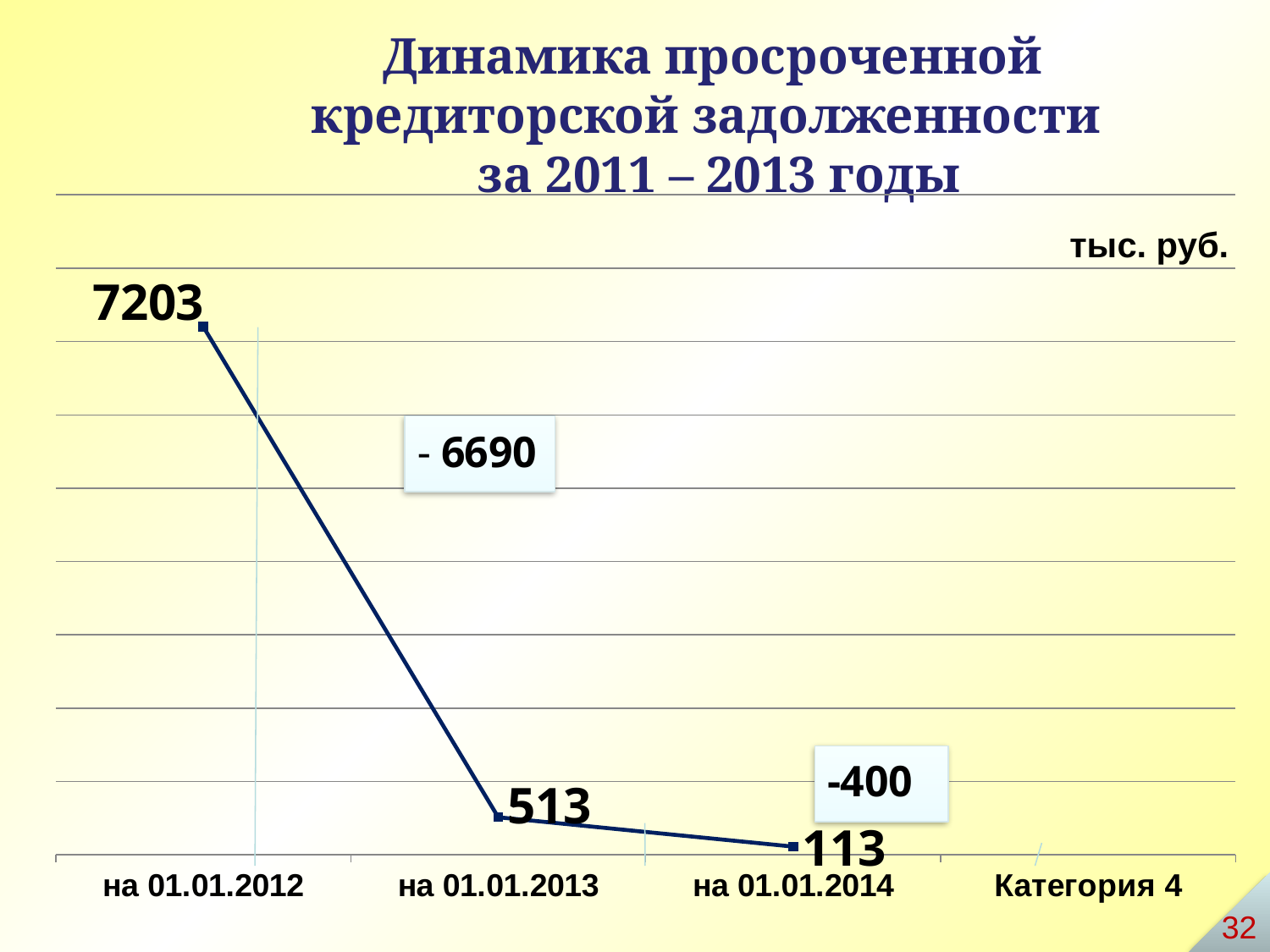
What is the value for на 01.01.2014? 113 Do the values rise or fall from на 01.01.2012 to на 01.01.2014? fall What is the difference between the values for на 01.01.2013 and на 01.01.2014? 400 Which date has the lowest value? на 01.01.2014 In what units are the values on the chart expressed? тыс. руб. What is the difference between the values for на 01.01.2012 and на 01.01.2013? 6690 Which date has the highest value? на 01.01.2012 Which is larger, the value for на 01.01.2013 or the value for на 01.01.2014? на 01.01.2013 What is the value for на 01.01.2012? 7203 What kind of chart is shown on the slide? line chart What is the value for на 01.01.2013? 513 How many data points are plotted on the line? 3